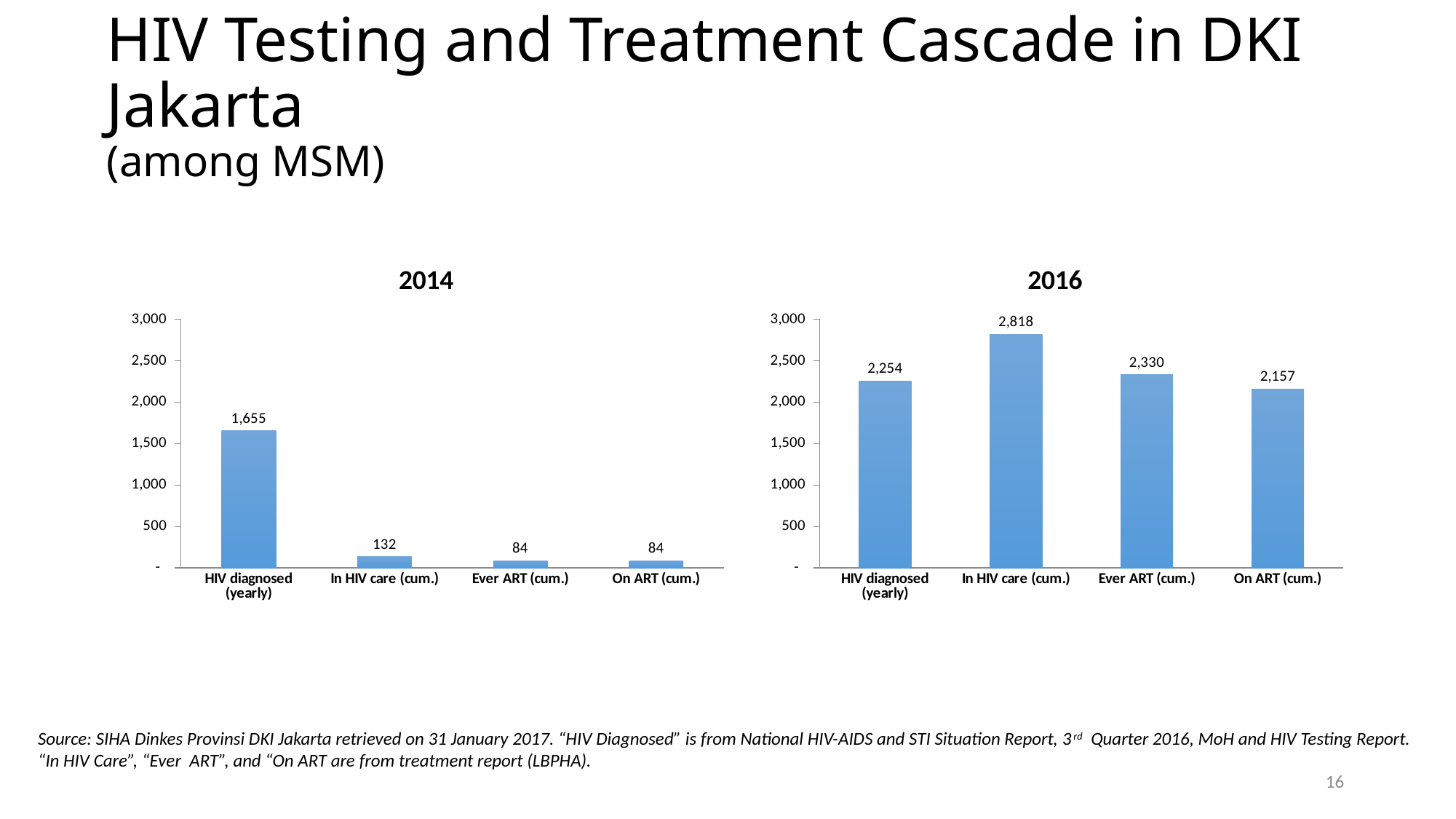
What type of chart is the 2014 chart? Bar chart In the 2016 chart, what is the value for On ART (cum.)? 2,157 In the 2016 chart, what is the value for In HIV care (cum.)? 2,818 In the 2014 chart, what is the value for HIV diagnosed (yearly)? 1,655 In the 2016 chart, which category has the lowest value? On ART (cum.) In the 2016 chart, which category has the highest value? In HIV care (cum.) In the 2014 chart, what is the difference between HIV diagnosed (yearly) and In HIV care (cum.)? 1,523 In the 2016 chart, what is the difference between In HIV care (cum.) and Ever ART (cum.)? 488 In the 2016 chart, which is larger: HIV diagnosed (yearly) or Ever ART (cum.)? Ever ART (cum.) How many categories are shown in the 2016 chart? 4 In the 2014 chart, which category has the highest value? HIV diagnosed (yearly) In the 2014 chart, what is the value for In HIV care (cum.)? 132